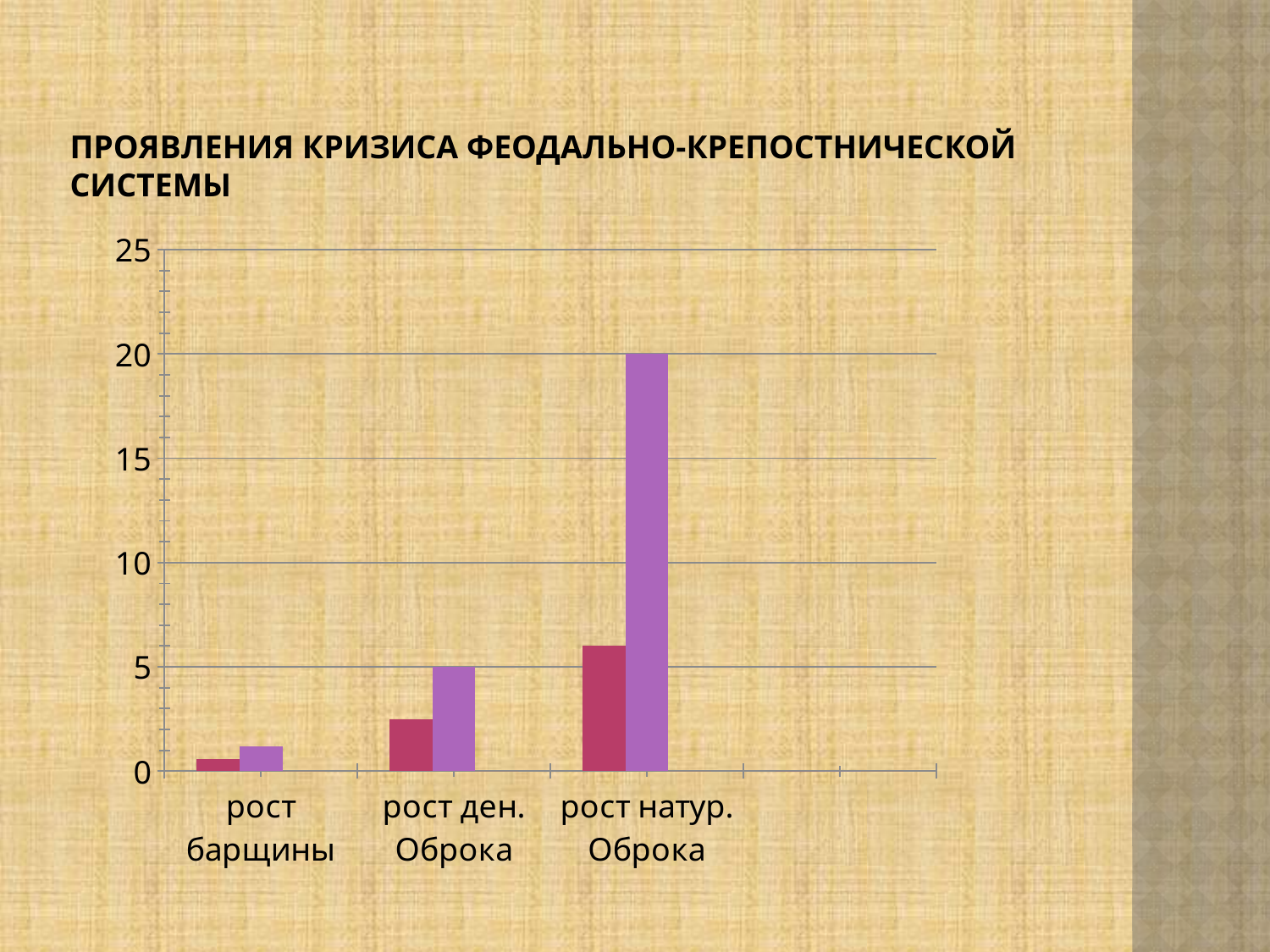
Is the value of the red bar for "рост ден. Оброка" greater or less than 5? less Which category has the tallest bar in the chart? рост натур. Оброка Which is larger: the purple bar for "рост натур. Оброка" or the purple bar for "рост ден. Оброка"? рост натур. Оброка What is the value of the purple bar for "рост натур. Оброка"? 20 What kind of chart is shown on the slide? bar chart Which category has the shortest bars in the chart? рост барщины What is the value of the purple bar for "рост ден. Оброка"? 5 Do the purple bars rise or fall from left to right across the categories? rise How many categories are shown on the x axis of the chart? 3 How many bars are plotted for each category in the chart? 2 What is the title of the slide containing the chart? ПРОЯВЛЕНИЯ КРИЗИСА ФЕОДАЛЬНО-КРЕПОСТНИЧЕСКОЙ СИСТЕМЫ Is the value of the red bar for "рост натур. Оброка" greater or less than 5? greater